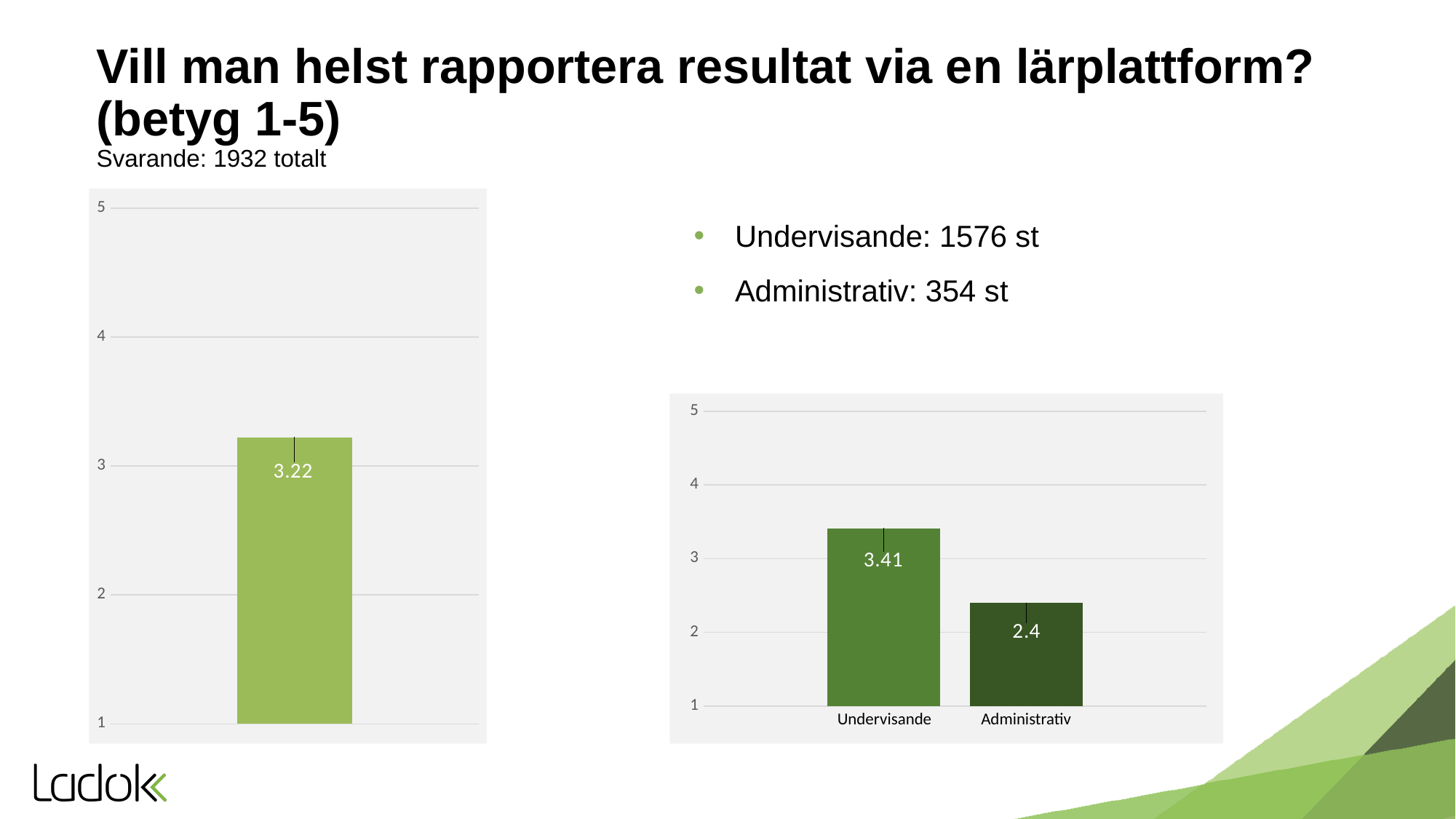
What type of chart is the left chart? bar chart On the right chart, what is the value for Undervisande? 3.41 What is the highest value shown on the y axis of the right chart? 5 On the right chart, what is the difference between the values for Undervisande and Administrativ? 1.01 On the right chart, what is the value for Administrativ? 2.4 On the left chart, what value is printed on the single bar? 3.22 On the right chart, which category has the lowest value? Administrativ On the right chart, is the value for Administrativ greater or less than 3? less On the left chart, is the value of the bar greater or less than 3? greater On the right chart, which category has the highest value? Undervisande On the right chart, which is larger, the value for Undervisande or the value for Administrativ? Undervisande How many bars are shown on the right chart? 2